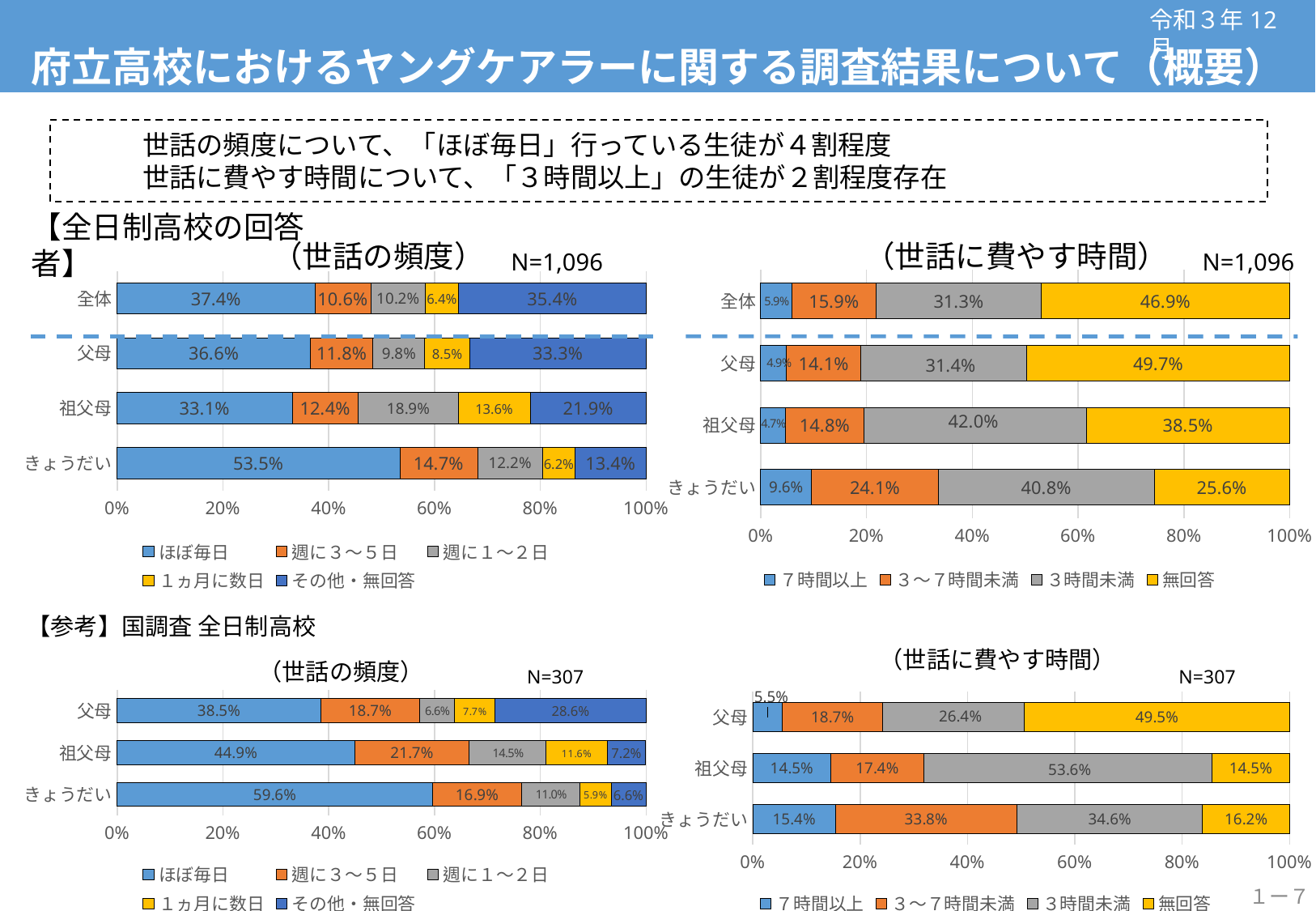
In the bottom-left chart (国調査 世話の頻度, N=307), what is the 週に3〜5日 value for 祖父母? 21.7% In the bottom-right chart (国調査 世話に費やす時間, N=307), what is the 3〜7時間未満 value for きょうだい? 33.8% In the top-left chart (世話の頻度, N=1,096), what is the difference between the ほぼ毎日 values for きょうだい and 全体? 16.1% In the top-right chart (世話に費やす時間, N=1,096), what is the 無回答 value for 全体? 46.9% In the bottom-right chart (国調査 世話に費やす時間, N=307), which is larger: the 3時間未満 value for 祖父母 or for きょうだい? 祖父母 In the top-left chart (世話の頻度, N=1,096), which category has the highest ほぼ毎日 value? きょうだい In the top-right chart (世話に費やす時間, N=1,096), which category has the lowest 7時間以上 value? 祖父母 How many categories are shown in the bottom-left chart (国調査 世話の頻度, N=307)? 3 In the top-left chart (世話の頻度, N=1,096), what is the ほぼ毎日 value for きょうだい? 53.5% What is the N value shown for the top-left chart (世話の頻度)? N=1,096 What kind of chart is the top-left chart (世話の頻度, N=1,096)? Stacked bar chart How many series does the legend of the top-right chart (世話に費やす時間, N=1,096) list? 4